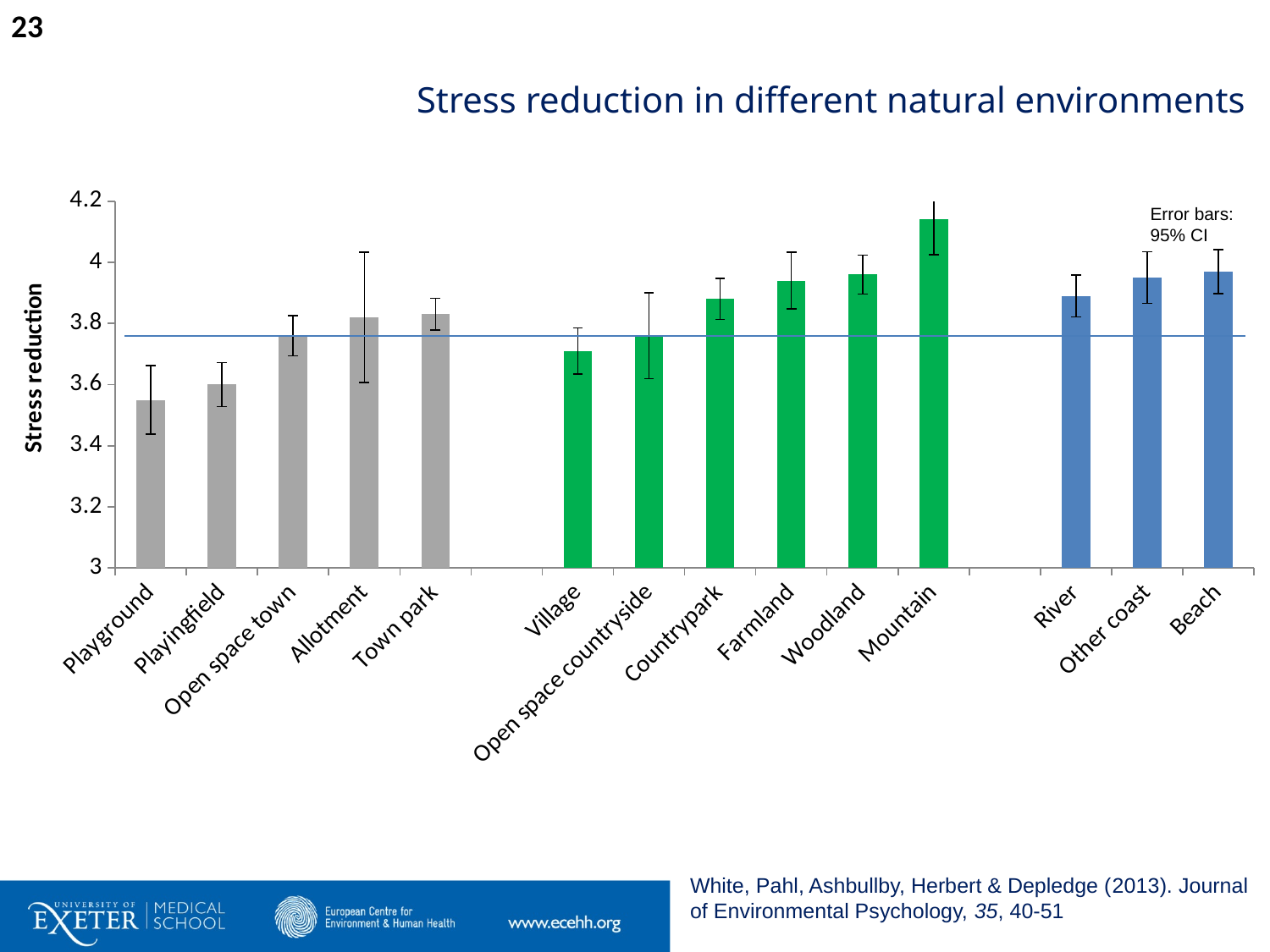
What kind of chart is shown on the slide? bar chart What is the title of the chart? Stress reduction in different natural environments What do the error bars on the chart represent? 95% CI Is the stress reduction value for Playground greater or less than 3.6? less Is the stress reduction value for Village greater or less than 3.8? less Which environment has the lowest stress reduction value? Playground How many environments (categories) are plotted on the x axis? 14 Is the stress reduction value for Mountain greater or less than 4? greater Which has a higher stress reduction value, Playingfield or Beach? Beach Which environment has the highest stress reduction value? Mountain Which has a higher stress reduction value, Farmland or Village? Farmland